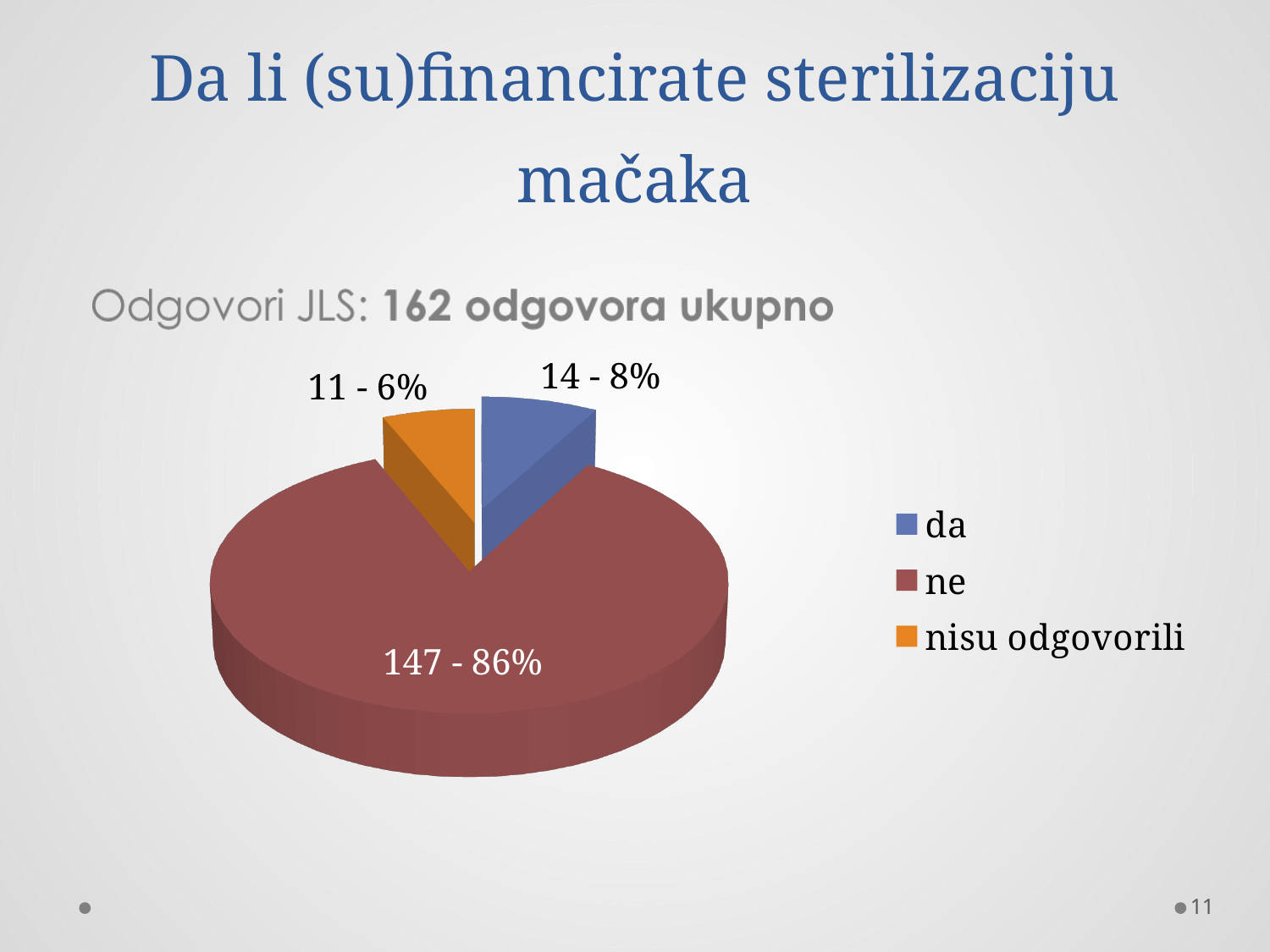
What percentage share does the 'da' slice have? 8% What is the difference between the counts for 'ne' and 'da'? 133 What is the count shown for the 'da' slice? 14 Which category has the smallest slice? nisu odgovorili How many entries does the legend list? 3 What kind of chart is shown on the slide? pie chart Which colour represents 'nisu odgovorili' in the legend? orange What is the count shown for the 'nisu odgovorili' slice? 11 What is the count shown for the 'ne' slice? 147 What percentage share does the 'ne' slice have? 86% How many slices does the pie chart have? 3 Which category has the largest slice? ne